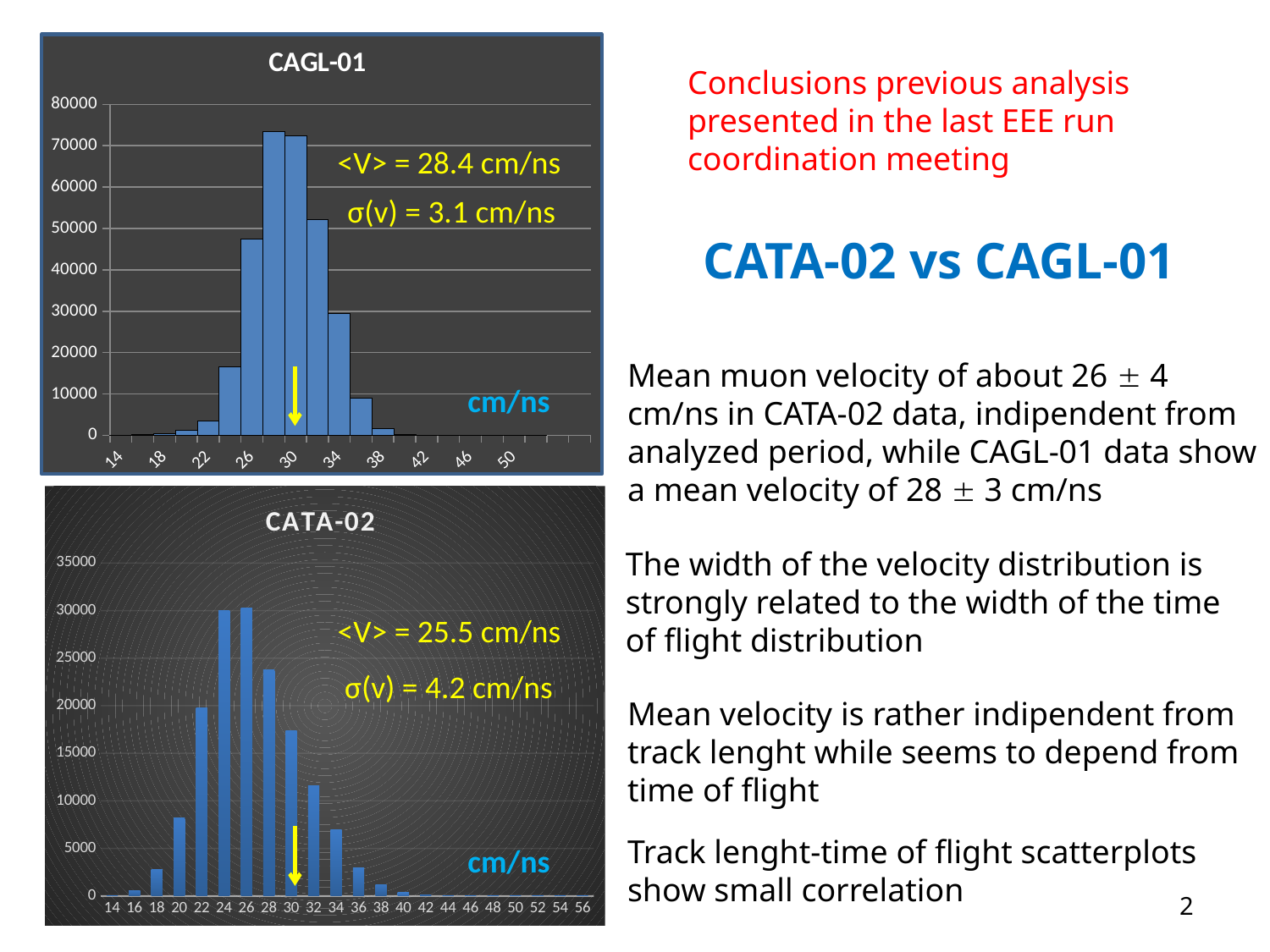
In the CATA-02 chart, is the value of the bar at 20 greater or less than 10000? less In the CATA-02 chart, is the value of the bar at 28 greater or less than 20000? greater In the CAGL-01 chart, which bar is taller, the one at 34 or the one at 38? 34 In the CATA-02 chart, which bar is taller, the one at 30 or the one at 32? 30 In the CAGL-01 chart, is the value of the bar at 36 greater or less than 20000? less What kind of chart is the CAGL-01 chart? bar chart What kind of chart is the CATA-02 chart? bar chart What value of σ(v) is annotated on the CATA-02 chart? 4.2 cm/ns What mean velocity <V> is annotated on the CAGL-01 chart? 28.4 cm/ns